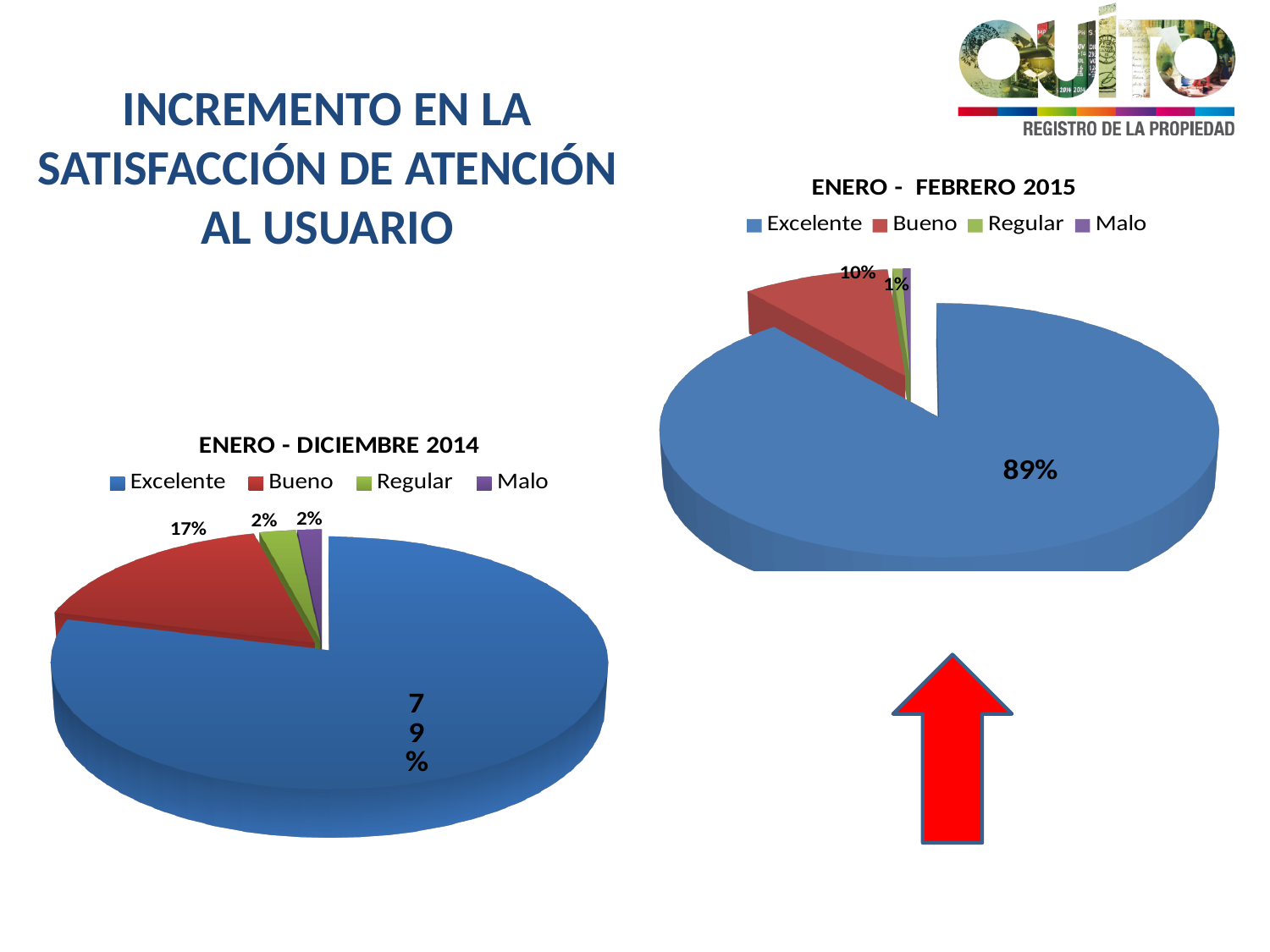
Is the Bueno share larger in the ENERO - DICIEMBRE 2014 chart or in the ENERO - FEBRERO 2015 chart? ENERO - DICIEMBRE 2014 In the ENERO - FEBRERO 2015 chart, which category has the largest share? Excelente In the ENERO - DICIEMBRE 2014 chart, what is the difference between the Excelente and Bueno shares? 62 percentage points In the ENERO - DICIEMBRE 2014 chart, which category has the largest share? Excelente What colour represents Excelente in both pie charts? Blue How many categories does the legend of the ENERO - FEBRERO 2015 chart list? 4 In the ENERO - FEBRERO 2015 chart, what percentage is shown for Bueno? 10% In the ENERO - DICIEMBRE 2014 chart, what percentage is shown for Excelente? 79% What kind of chart is the ENERO - DICIEMBRE 2014 chart? Pie chart In the ENERO - FEBRERO 2015 chart, what percentage is shown for Excelente? 89% In the ENERO - DICIEMBRE 2014 chart, what percentage is shown for Bueno? 17% By how many percentage points did the Excelente share increase from the ENERO - DICIEMBRE 2014 chart to the ENERO - FEBRERO 2015 chart? 10 percentage points